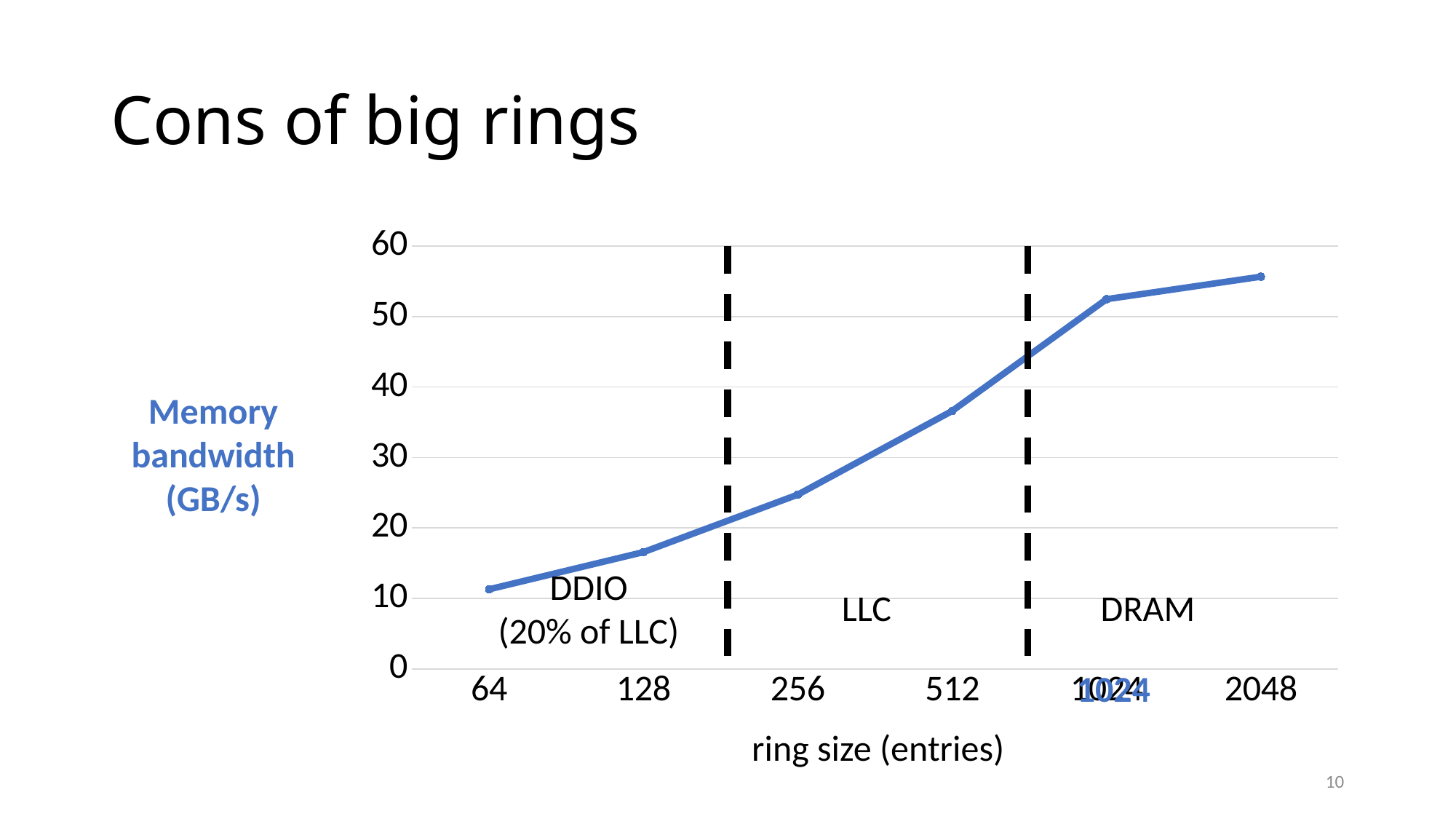
Is the memory bandwidth for a ring size of 64 greater or less than 20 GB/s? less Is the memory bandwidth for a ring size of 512 greater or less than 30 GB/s? greater Does memory bandwidth rise or fall as ring size increases? rise What kind of chart is shown on the slide? line chart Which has higher memory bandwidth, a ring size of 128 or a ring size of 512? 512 How many ring sizes are plotted along the x axis? 6 What is the label of the x axis? ring size (entries) Which ring size has the lowest memory bandwidth? 64 Is the memory bandwidth for a ring size of 256 greater or less than 30 GB/s? less Which region label is shown between the two dashed vertical lines? LLC Which ring size has the highest memory bandwidth? 2048